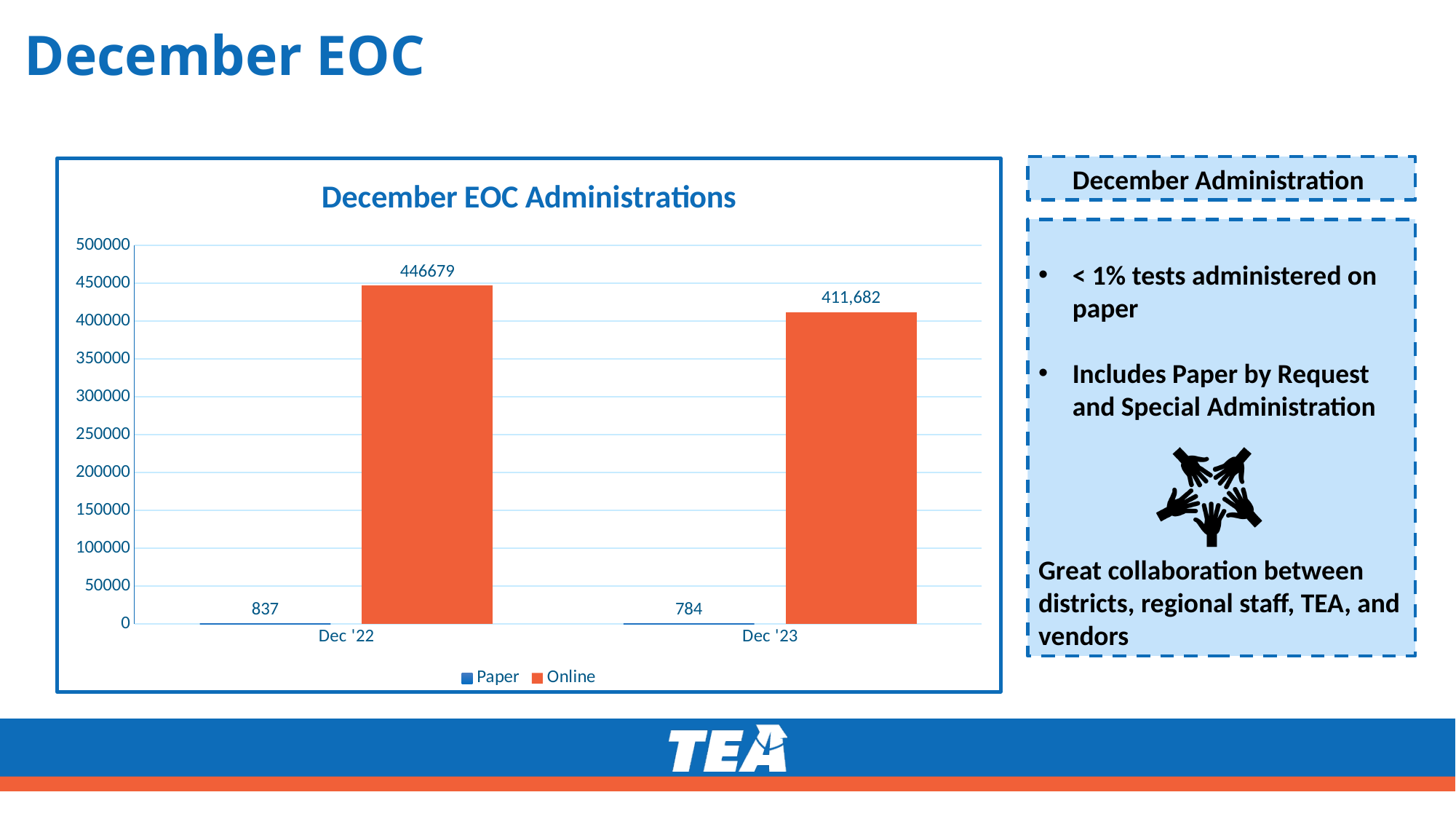
What is the Paper value for Dec '23 in the December EOC Administrations chart? 784 What is the Online value for Dec '22 in the December EOC Administrations chart? 446679 Which category has the higher Online value in the December EOC Administrations chart, Dec '22 or Dec '23? Dec '22 What is the difference between the Online values for Dec '22 and Dec '23 in the December EOC Administrations chart? 34997 How many series does the legend of the December EOC Administrations chart list? 2 Does the Online value rise or fall from Dec '22 to Dec '23 in the December EOC Administrations chart? Fall What is the Paper value for Dec '22 in the December EOC Administrations chart? 837 What kind of chart is the December EOC Administrations chart? Bar chart What is the Online value for Dec '23 in the December EOC Administrations chart? 411,682 Which category has the lowest Paper value in the December EOC Administrations chart? Dec '23 How many categories are shown on the x axis of the December EOC Administrations chart? 2 What is the difference between the Paper values for Dec '22 and Dec '23 in the December EOC Administrations chart? 53